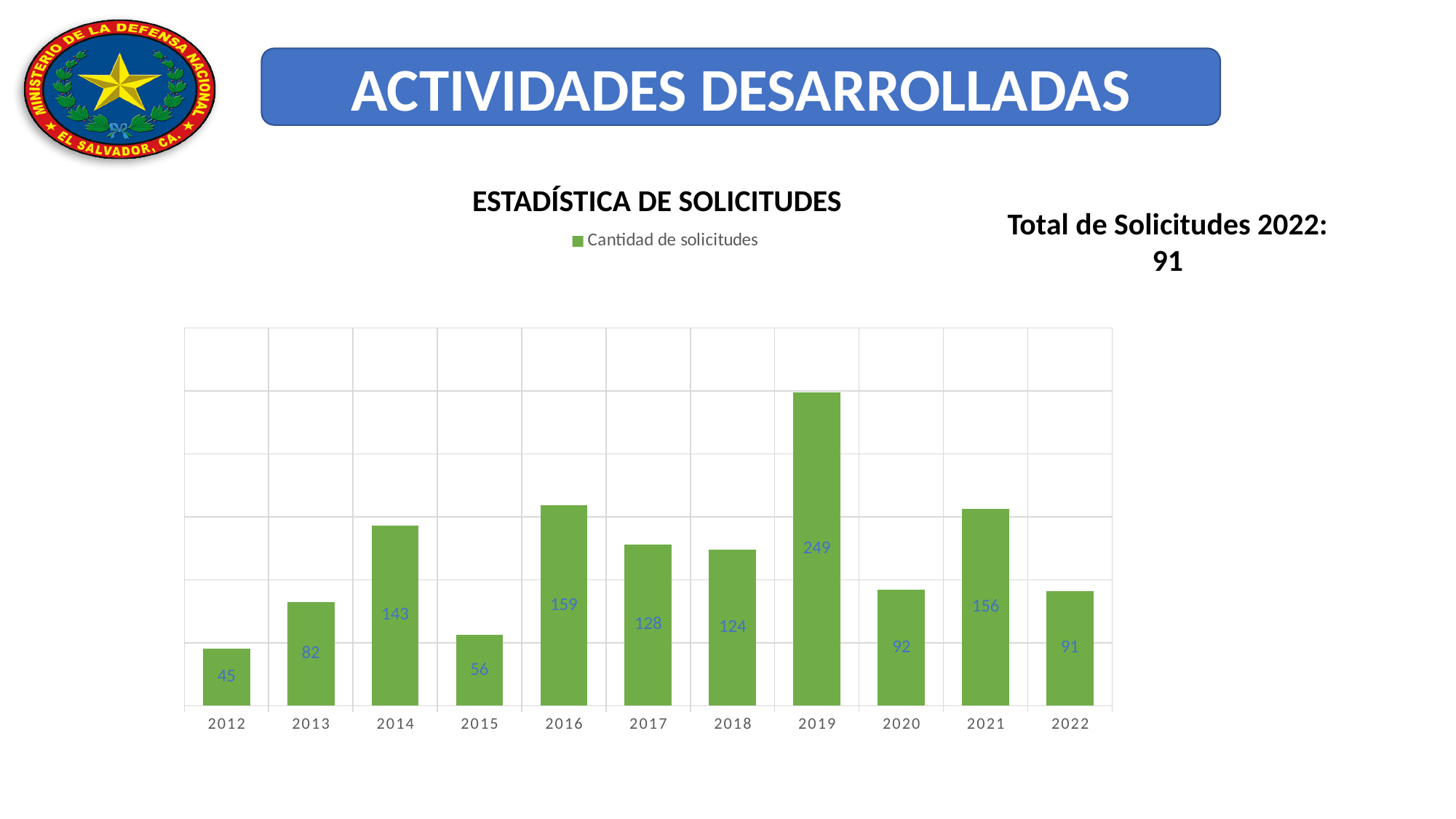
Which year has the highest number of solicitudes? 2019 What is the value for 2014 in the chart? 143 Which is larger, the value for 2017 or the value for 2018? 2017 What is the value for 2019 in the chart? 249 What is the value for 2022 in the chart? 91 What is the title of the chart? ESTADÍSTICA DE SOLICITUDES What is the difference between the values for 2016 and 2015? 103 What is the difference between the values for 2019 and 2021? 93 How many years are shown on the x axis of the chart? 11 What kind of chart is shown on the slide? Bar chart Which year has the lowest number of solicitudes? 2012 How many series does the legend list? 1